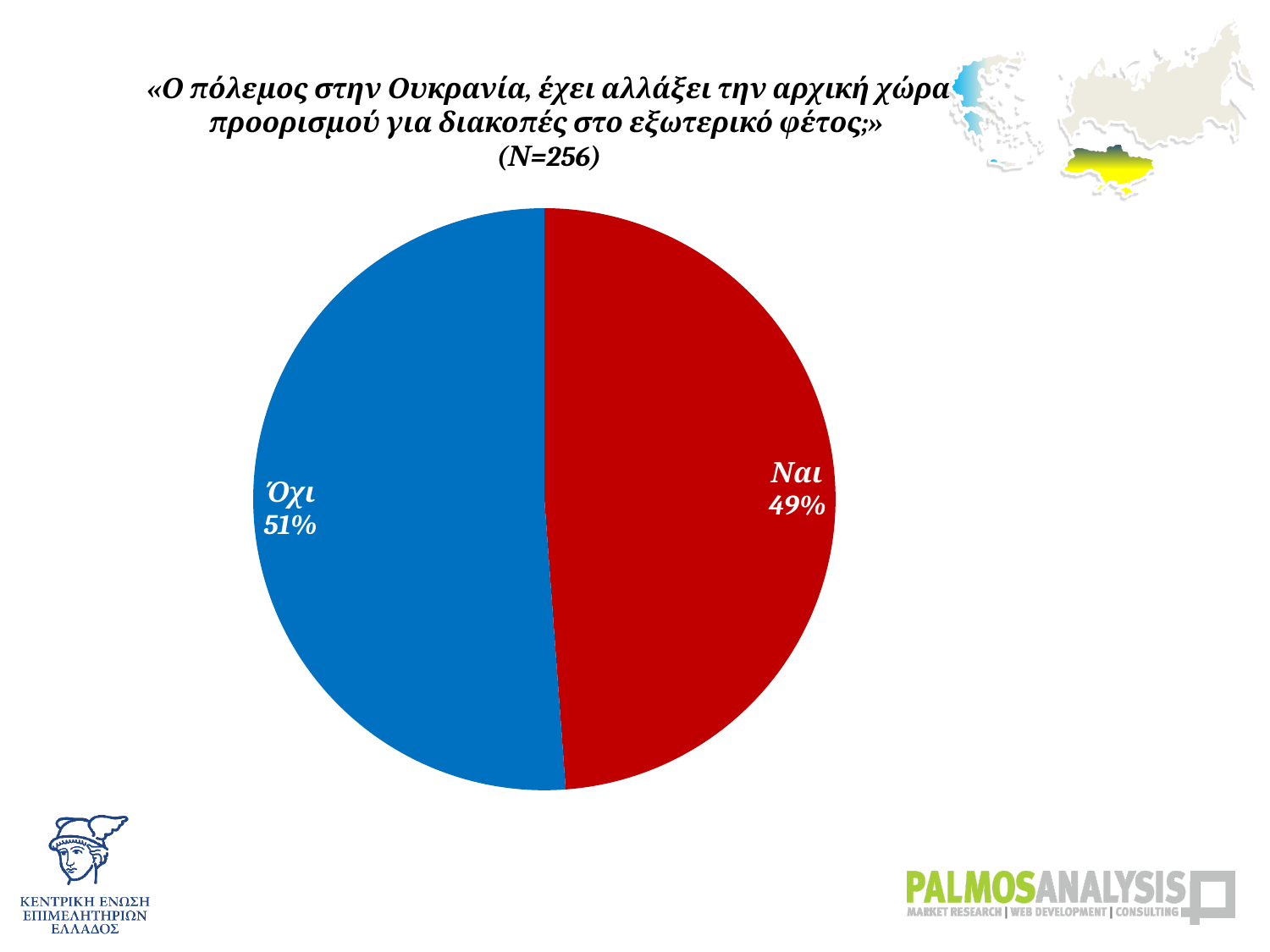
What percentage of respondents answered Ναι? 49% Is the share for Ναι greater or less than 50%? less Which response has the largest share of the pie? Όχι What is the combined share of the Όχι and Ναι slices? 100% Which response has the smallest share of the pie? Ναι What is the difference in percentage points between the Όχι and Ναι slices? 2 percentage points What colour is the Ναι slice of the pie? Red What kind of chart is shown on the slide? Pie chart What percentage of respondents answered Όχι? 51% How many slices does the pie chart have? 2 Which response has the larger share of the pie, Όχι or Ναι? Όχι What is the sample size (N) stated in the chart title? 256